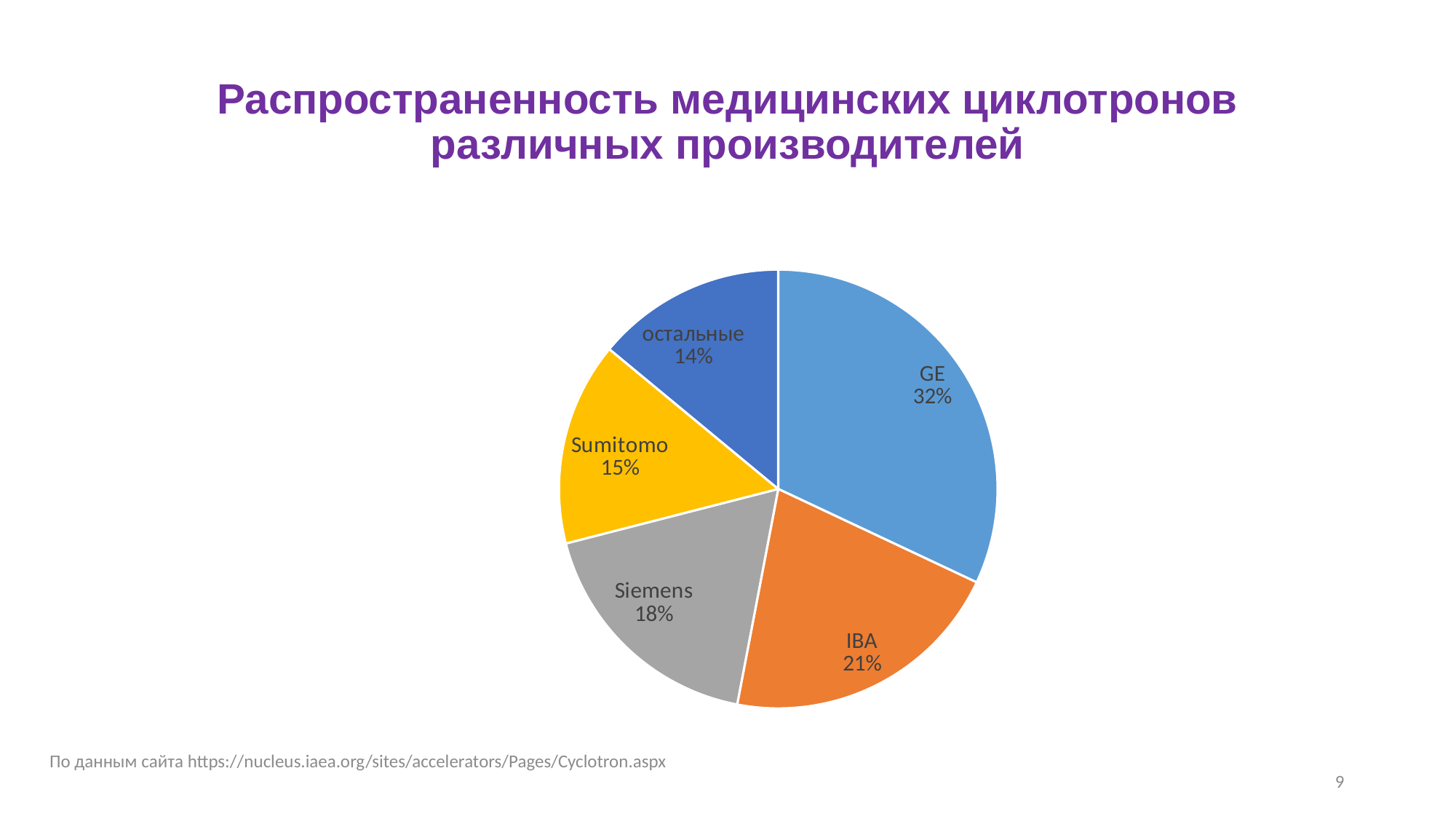
What percentage is shown for IBA? 21% What share is shown for Sumitomo? 15% Which manufacturer has the largest slice of the pie? GE Which is larger, the Siemens slice or the Sumitomo slice? Siemens Which slice is the smallest? остальные What percentage is labelled for the 'остальные' slice? 14% What type of chart is shown on the slide? pie chart What is the difference between the GE share and the IBA share? 11% How many slices does the pie chart have? 5 What is the value for Siemens? 18% What share of the pie does GE hold? 32% What colour is the GE slice? light blue